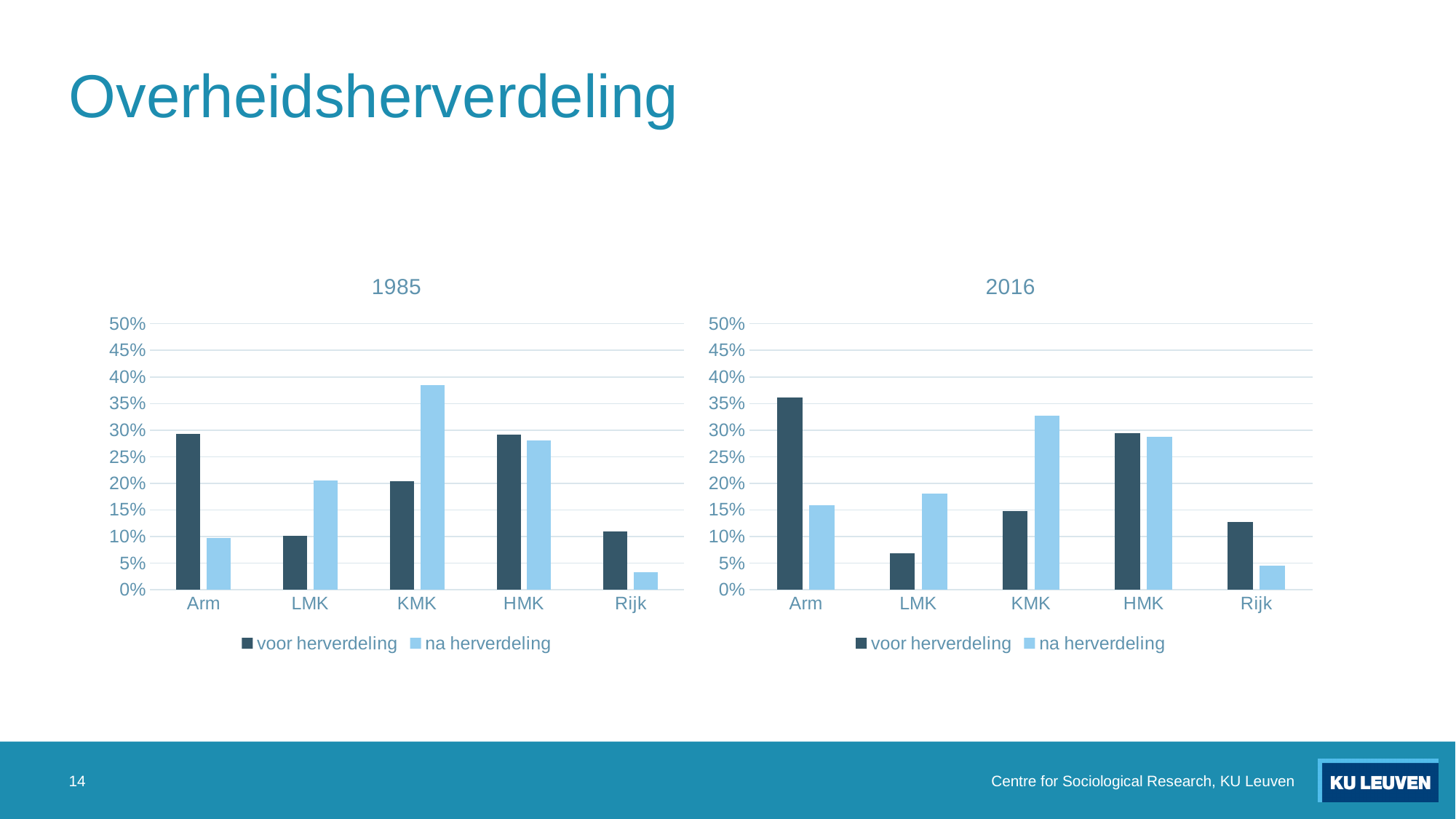
In the 1985 chart, for LMK, which is larger: voor herverdeling or na herverdeling? na herverdeling How many categories are shown on the x axis of the 2016 chart? 5 What kind of chart is the 1985 chart? bar chart In the 2016 chart, is the voor herverdeling value for Arm greater or less than 30%? greater What are the two legend entries of the 2016 chart? voor herverdeling, na herverdeling In the 2016 chart, which category has the highest value for voor herverdeling? Arm In the 1985 chart, is the na herverdeling value for KMK greater or less than 35%? greater In the 1985 chart, which category has the lowest value for na herverdeling? Rijk How many series does the legend of the 1985 chart list? 2 In the 2016 chart, which category has the lowest value for voor herverdeling? LMK In the 2016 chart, for Rijk, which is larger: voor herverdeling or na herverdeling? voor herverdeling In the 1985 chart, which category has the highest value for na herverdeling? KMK